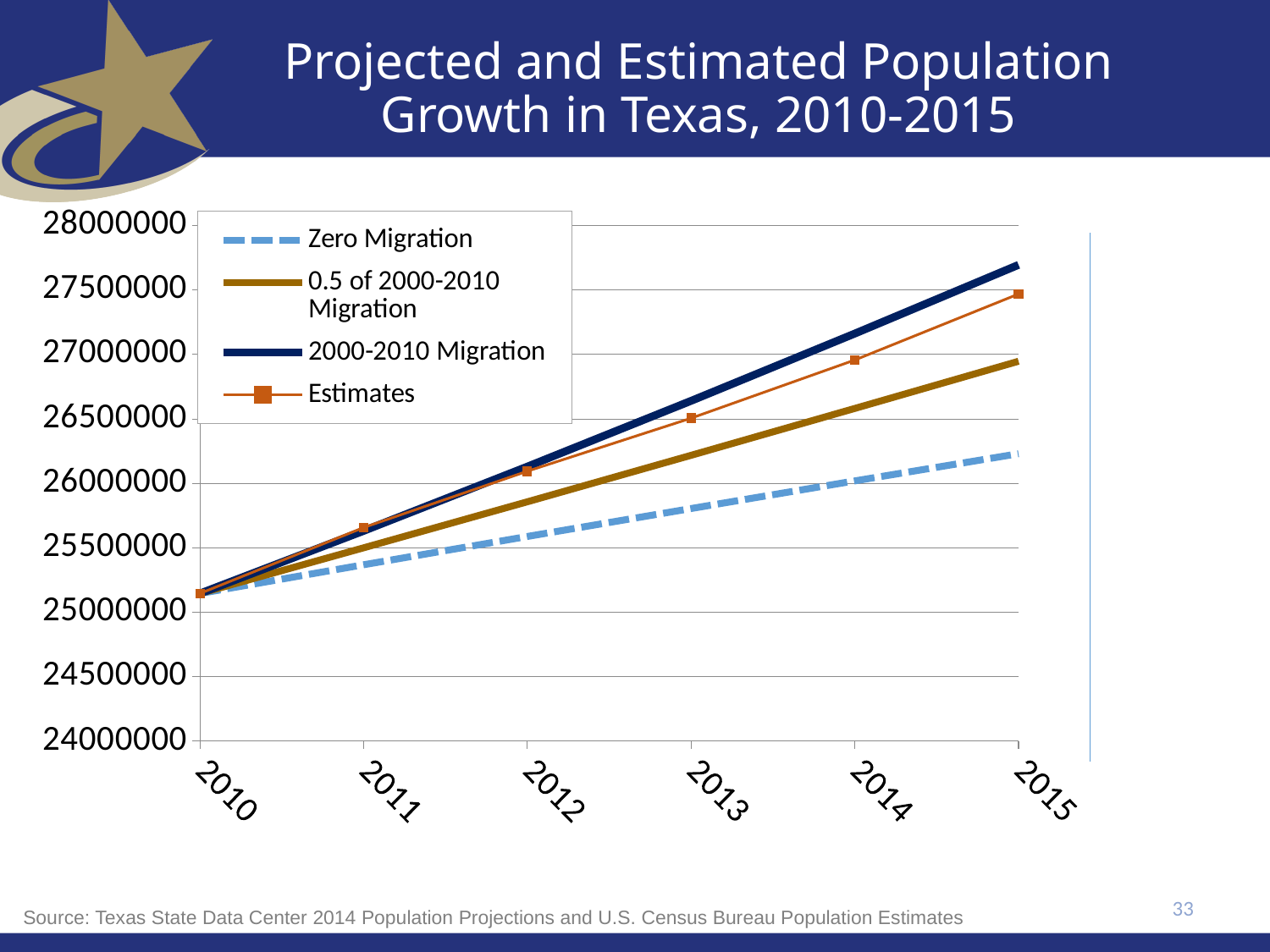
Is the value for Zero Migration in 2013 greater or less than 25500000? greater Which series is drawn with a dashed line? Zero Migration What kind of chart is shown on the slide? line chart Do the values for the Estimates series rise or fall from 2010 to 2015? rise Is the value for 2000-2010 Migration in 2015 greater or less than 27500000? greater How many years are shown along the x axis? 6 How many series does the legend list? 4 Is the value for Estimates in 2015 greater or less than 27000000? greater In 2015, which is larger: the 2000-2010 Migration value or the Zero Migration value? 2000-2010 Migration Which series has the highest value in 2015? 2000-2010 Migration Which series has the lowest value in 2015? Zero Migration